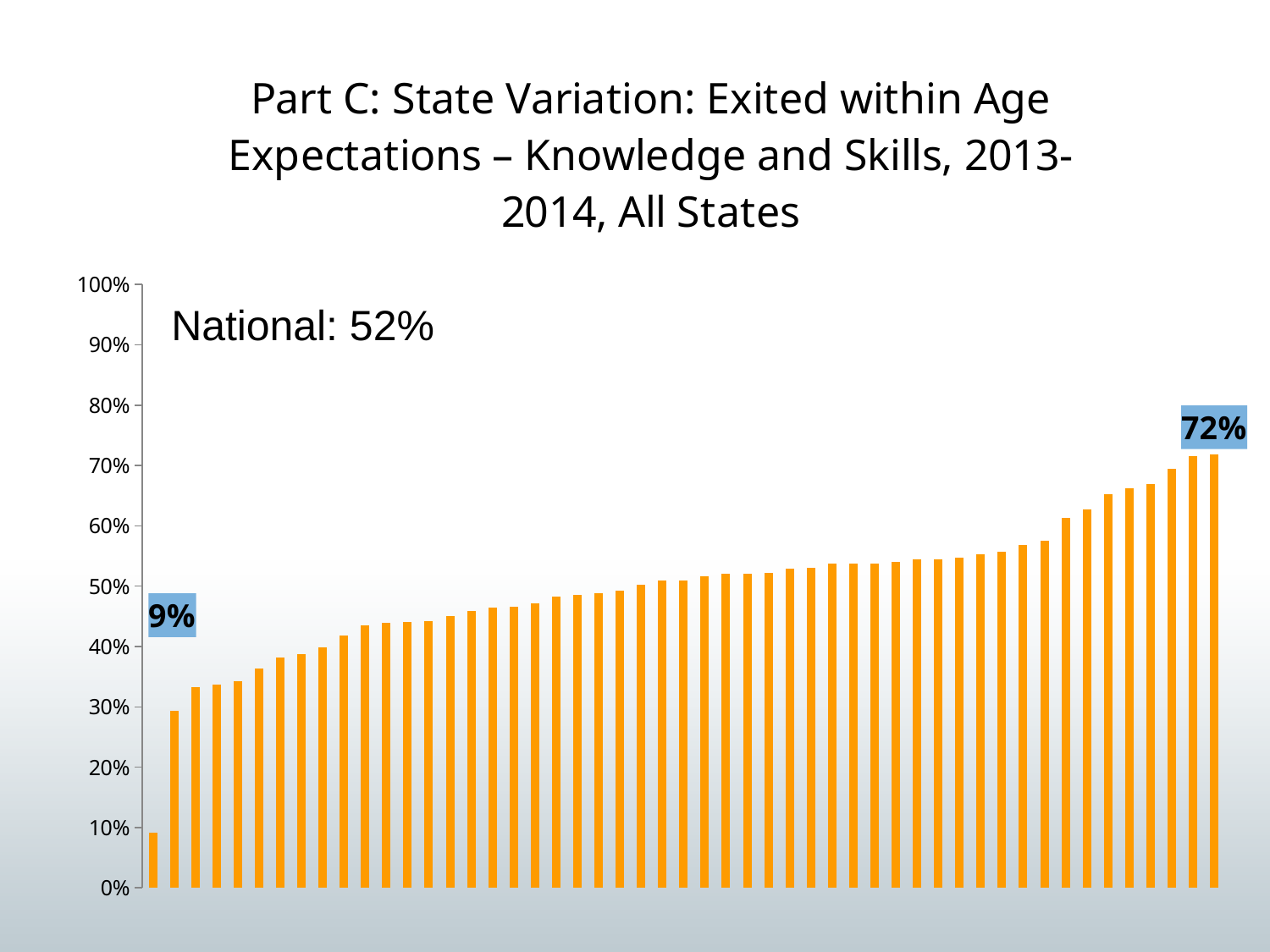
What national value is printed on the chart? 52% Is the value of the rightmost bar greater or less than 70%? greater Do the bar values rise or fall from left to right across the chart? rise What kind of chart is shown on the slide? bar chart Which is larger, the leftmost bar labelled 9% or the rightmost bar labelled 72%? the rightmost bar (72%) What is the value printed on the lowest bar in the chart? 9% What is the difference between the highest labelled bar (72%) and the lowest labelled bar (9%)? 63 percentage points What is the value printed on the highest bar in the chart? 72% What is the title of the chart on the slide? Part C: State Variation: Exited within Age Expectations – Knowledge and Skills, 2013-2014, All States What is the highest value shown on the vertical axis? 100% Is the value of the leftmost bar greater or less than 10%? less